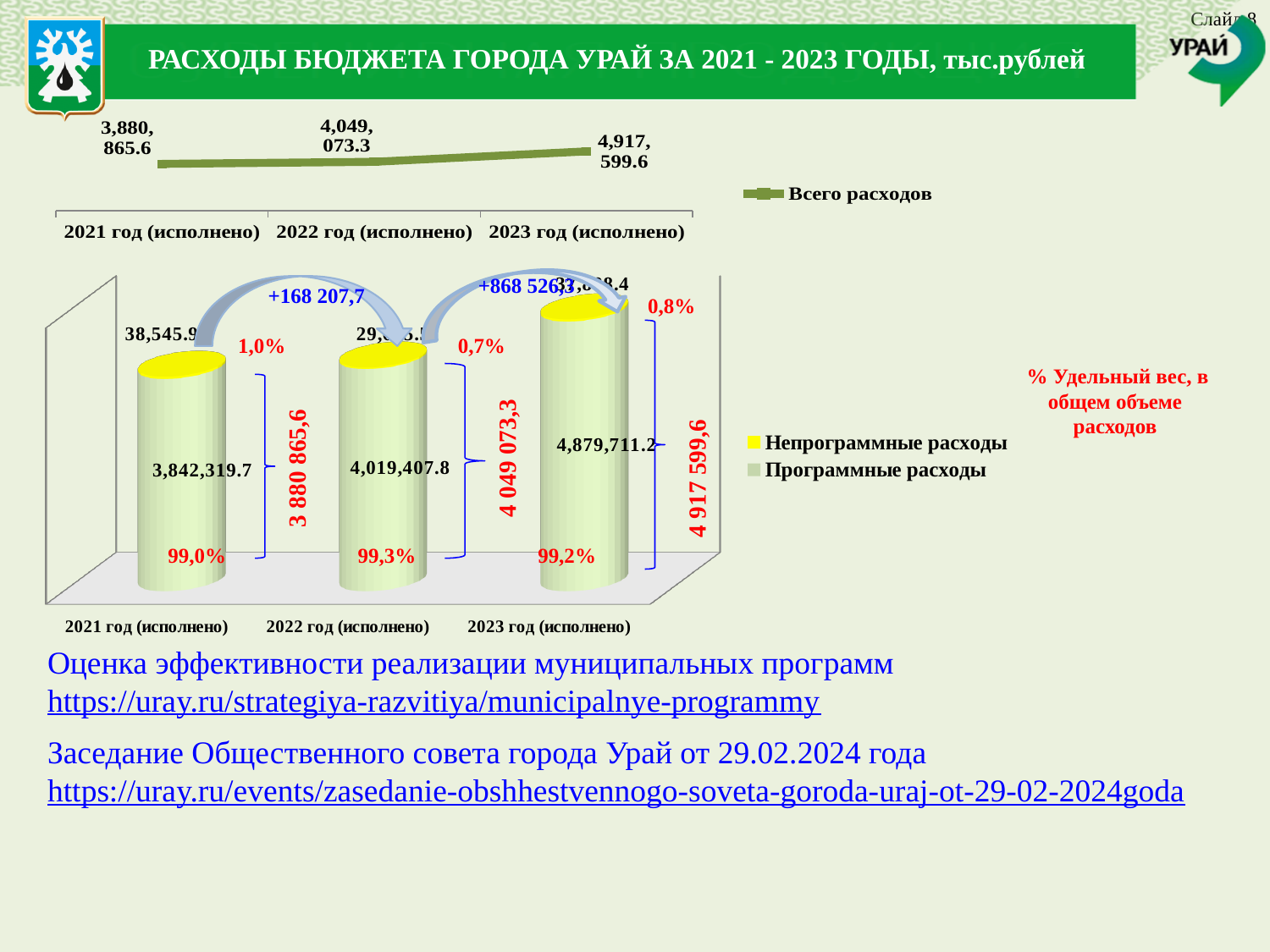
On the lower stacked bar chart, what is the total of the 2021 год (исполнено) bar (Непрограммные plus Программные расходы)? 3,880,865.6 On the lower stacked bar chart, what is the value of Программные расходы for 2023 год (исполнено)? 4,879,711.2 On the lower stacked bar chart, what is the value of Непрограммные расходы for 2021 год (исполнено)? 38,545.9 On the top line chart (Всего расходов), which year has the highest value? 2023 год (исполнено) On the top line chart (Всего расходов), what is the difference between the 2022 and 2021 values? 168,207.7 On the top line chart (Всего расходов), what is the value for 2021 год (исполнено)? 3,880,865.6 On the lower stacked bar chart, what is the value of Программные расходы for 2022 год (исполнено)? 4,019,407.8 On the top line chart (Всего расходов), do the values rise or fall from 2021 to 2023? rise On the lower stacked bar chart, which is larger: Программные расходы for 2021 or for 2023? 2023 год (исполнено) On the top line chart (Всего расходов), what is the value for 2023 год (исполнено)? 4,917,599.6 How many series does the legend of the lower stacked bar chart list? 2 On the top line chart (Всего расходов), what is the difference between the 2023 and 2022 values? 868,526.3